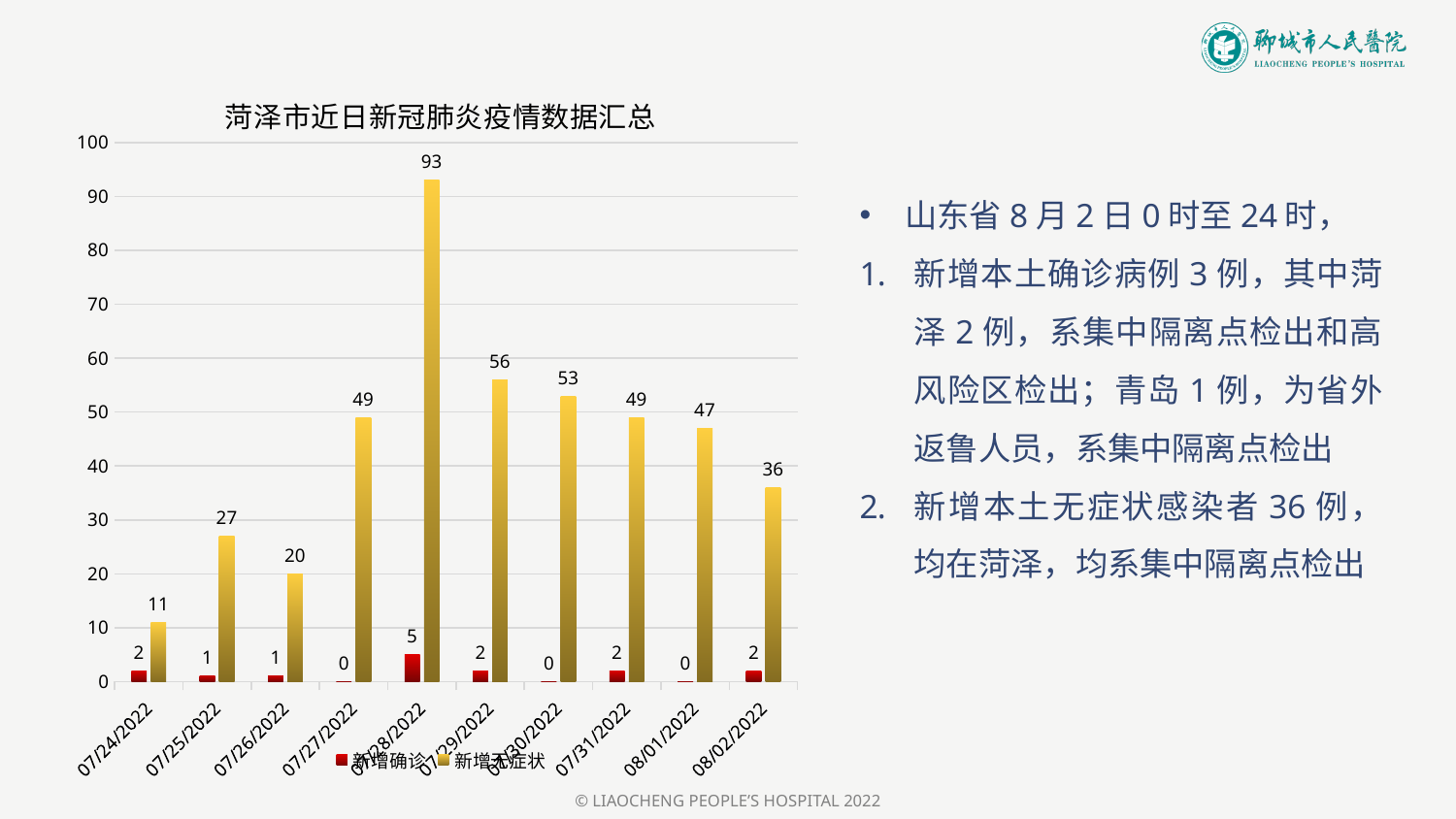
Which date has the highest 新增无症状 value? 07/28/2022 Which is larger, the 新增无症状 value for 07/25/2022 or for 07/26/2022? 07/25/2022 What is the value of 新增无症状 for 07/28/2022? 93 What is the value of 新增无症状 for 08/02/2022? 36 What is the difference between the 新增无症状 values for 07/28/2022 and 07/29/2022? 37 What is the value of 新增确诊 for 07/28/2022? 5 What is the title of the chart? 菏泽市近日新冠肺炎疫情数据汇总 Which date has the lowest 新增无症状 value? 07/24/2022 How many series does the legend list? 2 What kind of chart is shown on the slide? bar chart How many dates are shown on the x axis? 10 What is the total of the 新增确诊 and 新增无症状 values for 07/24/2022? 13